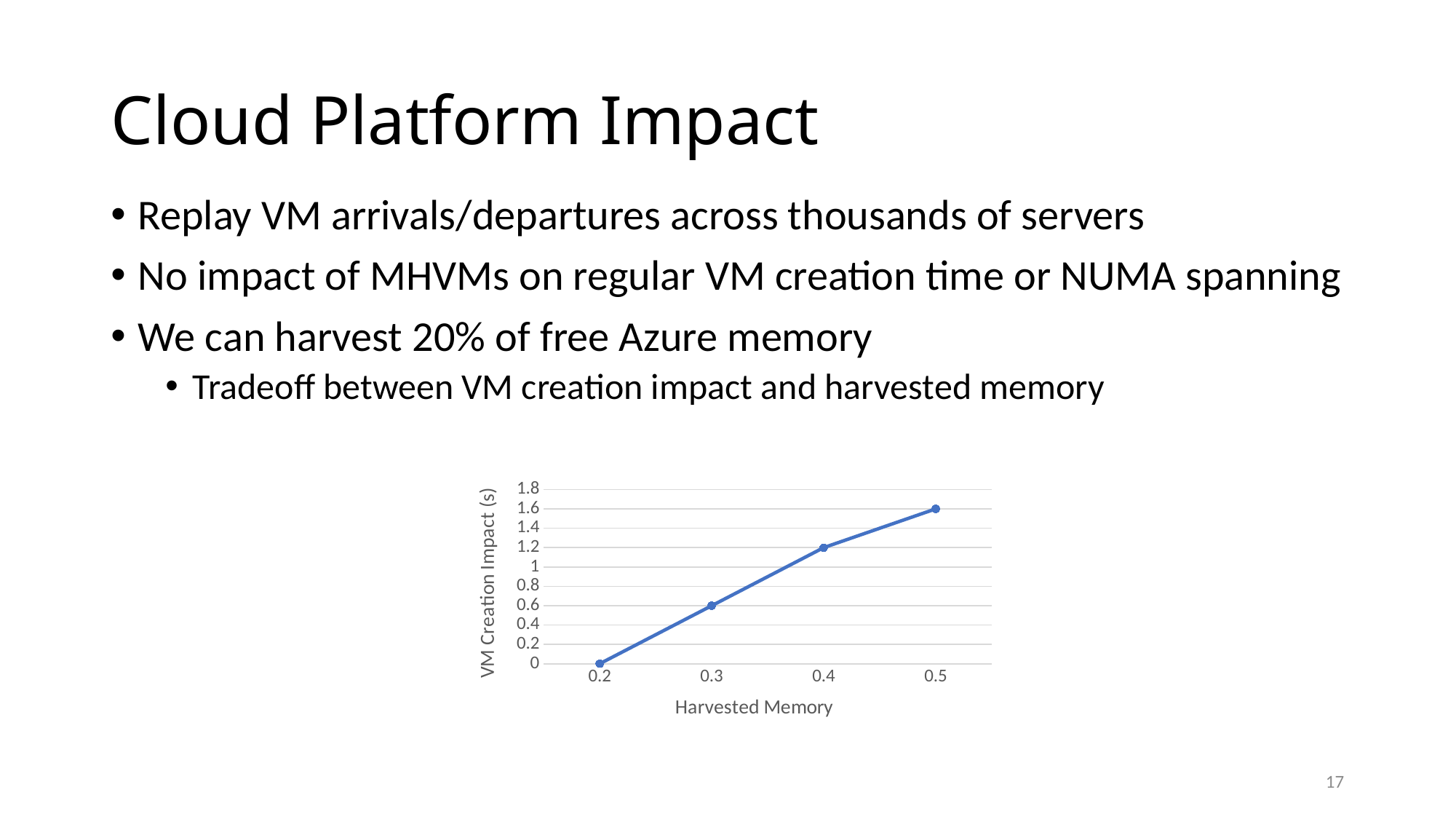
Does the VM Creation Impact rise or fall as Harvested Memory increases? rise What is the VM Creation Impact (s) when Harvested Memory is 0.5? 1.6 At which Harvested Memory value is the VM Creation Impact highest? 0.5 What is the VM Creation Impact (s) when Harvested Memory is 0.2? 0 Is the VM Creation Impact at Harvested Memory 0.5 greater or less than 1.4? greater Is the VM Creation Impact at Harvested Memory 0.3 greater or less than 0.8? less Which has a larger VM Creation Impact: Harvested Memory 0.3 or 0.4? 0.4 How many data points are plotted on the chart? 4 What is the VM Creation Impact (s) when Harvested Memory is 0.4? 1.2 What is the label of the x axis of the chart? Harvested Memory At which Harvested Memory value is the VM Creation Impact lowest? 0.2 What kind of chart is shown on the slide? line chart